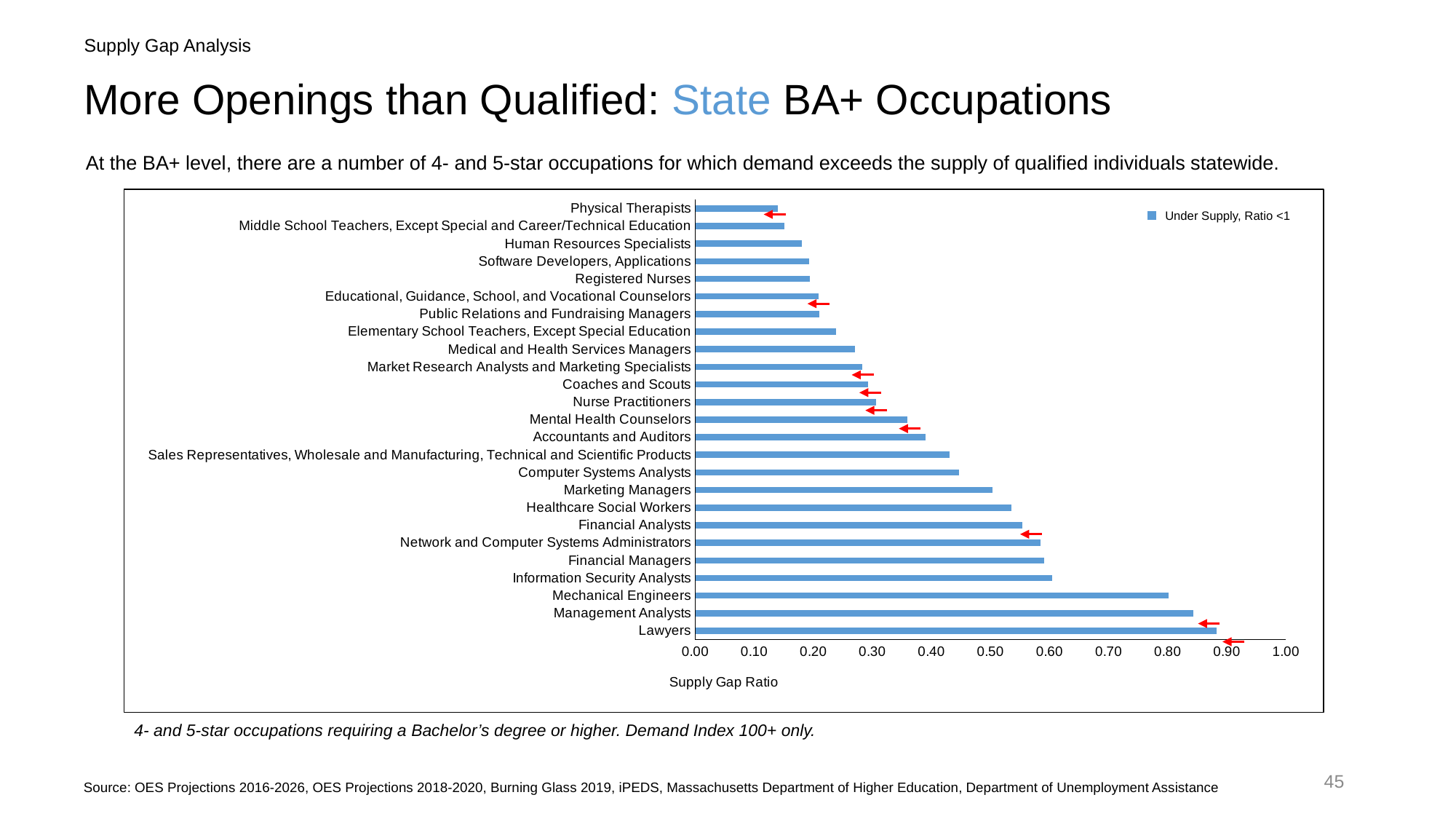
Which has a larger supply gap ratio, Human Resources Specialists or Medical and Health Services Managers? Medical and Health Services Managers Is the supply gap ratio for Physical Therapists greater or less than 0.20? less How many occupations are plotted in the chart? 25 What is the legend entry shown in the chart? Under Supply, Ratio <1 What is the title of the horizontal axis of the chart? Supply Gap Ratio Which occupation has the highest supply gap ratio in the chart? Lawyers Is the supply gap ratio for Registered Nurses greater or less than 0.30? less What kind of chart is shown on the slide? bar chart How many series does the chart legend list? 1 Is the supply gap ratio for Lawyers greater or less than 0.80? greater Which has a larger supply gap ratio, Mechanical Engineers or Information Security Analysts? Mechanical Engineers